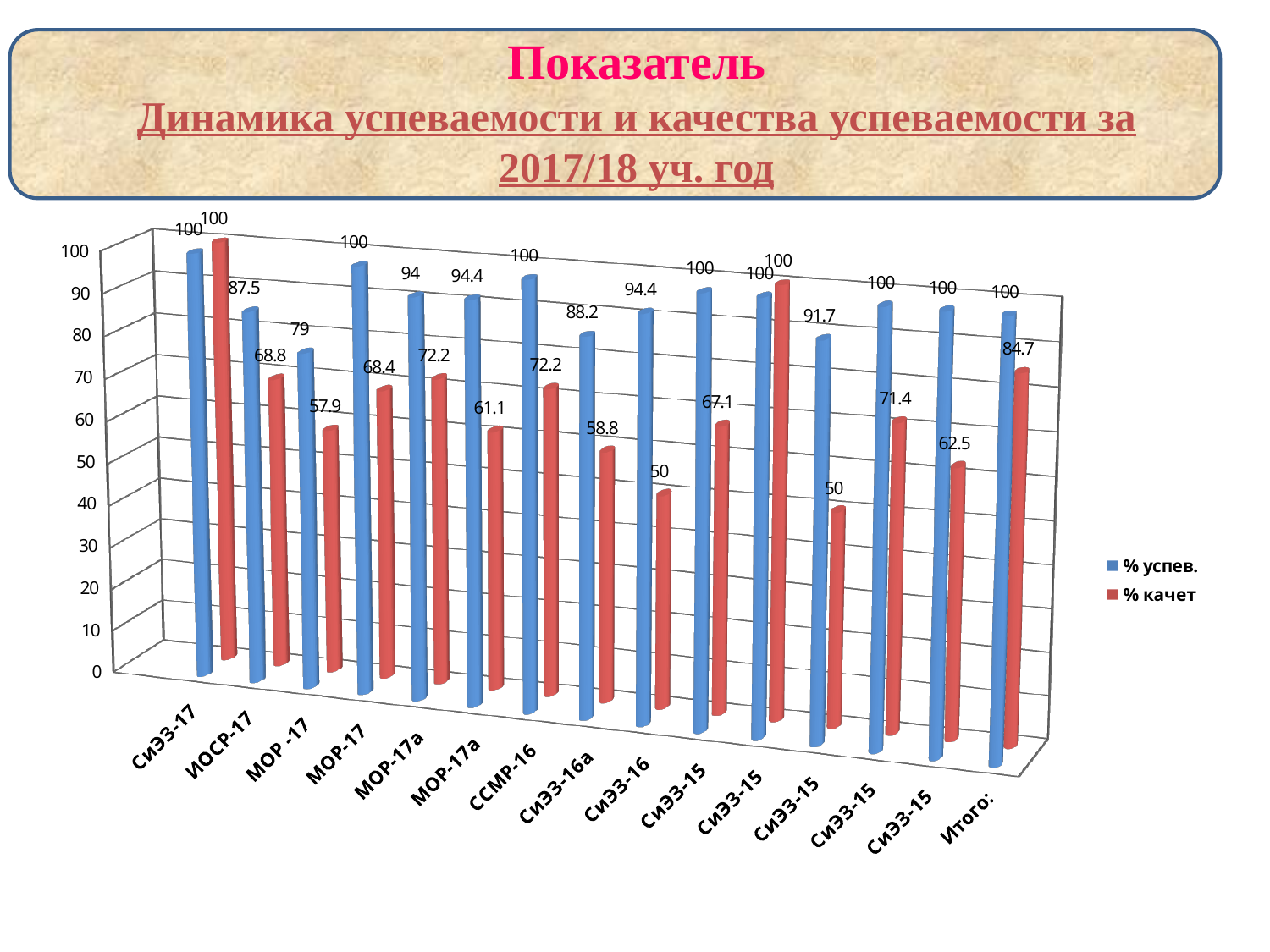
What kind of chart is shown on the slide? bar chart How many series does the legend list? 2 What is the % качет value for ИОСР-17? 68.8 What is the % качет value for Итого? 84.7 What is the % качет value for СиЭЗ-16? 50 Which has the higher % качет value, ССМР-16 or СиЭЗ-16? ССМР-16 How many categories are shown on the x axis? 15 What is the % успев. value for СиЭЗ-16а? 88.2 Which category has the lowest % успев. value? МОР -17 What is the % успев. value for ССМР-16? 100 What is the difference between % успев. and % качет for Итого? 15.3 What is the difference between % успев. and % качет for ИОСР-17? 18.7